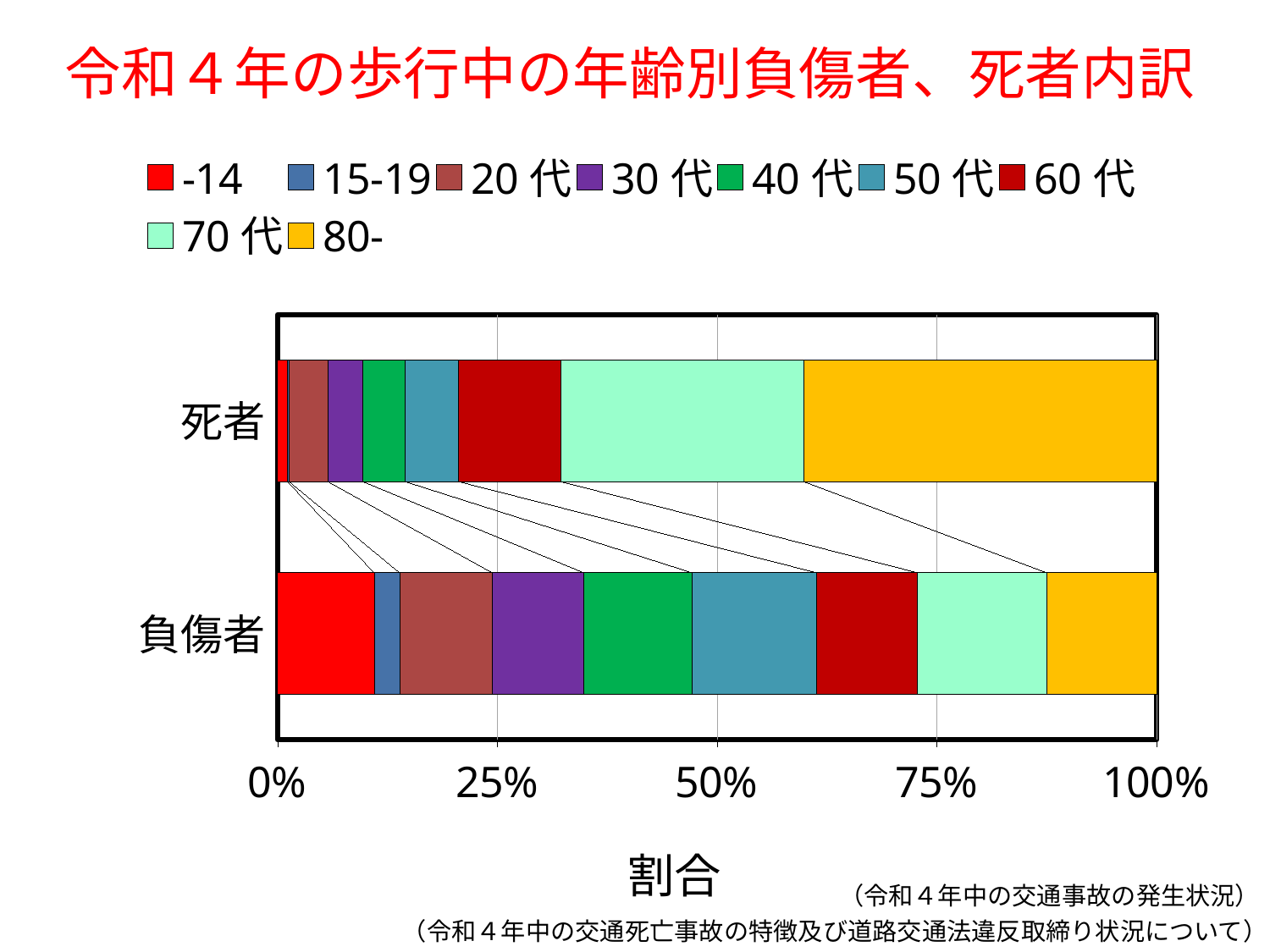
Is the share of 50 代 larger in the 死者 bar or in the 負傷者 bar? 負傷者 What is the label of the horizontal axis? 割合 How many series does the legend list? 9 What is the title of the chart on the slide? 令和４年の歩行中の年齢別負傷者、死者内訳 Is the share of -14 in the 負傷者 bar greater or less than 25%? less Is the share of 80- larger in the 死者 bar or in the 負傷者 bar? 死者 Which age group has the smallest share in the 負傷者 bar? 15-19 Which age group has the largest share in the 死者 bar? 80- What kind of chart is shown on the slide? Stacked bar chart Which age group has the smallest share in the 死者 bar? 15-19 How many categories (bars) does the chart show? 2 Is the share of 80- in the 死者 bar greater or less than 25%? greater